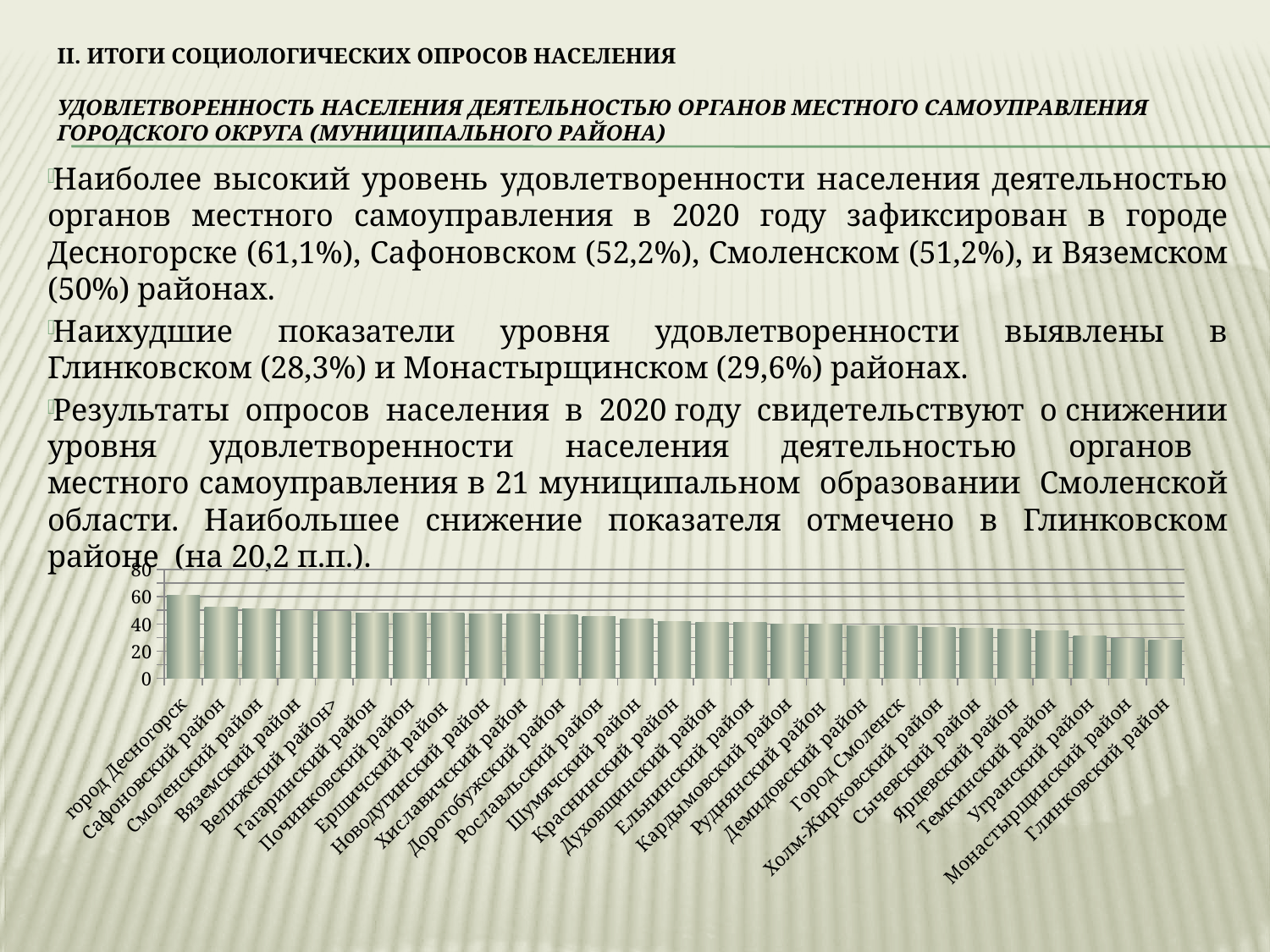
Is the value for Глинковский район greater or less than 40? less Which category has the highest bar in the chart? город Десногорск How many categories (municipalities) are shown on the x axis of the chart? 27 What is the highest tick value shown on the vertical axis of the chart? 80 Is the value for город Десногорск greater or less than 40? greater Is the value for Город Смоленск greater or less than 60? less Which is larger, the value for Сафоновский район or the value for Угранский район? Сафоновский район What kind of chart is shown at the bottom of the slide? bar chart Do the bar values rise or fall moving from left to right along the x axis? fall Which category has the lowest bar in the chart? Глинковский район Which is larger, the value for город Десногорск or the value for Глинковский район? город Десногорск